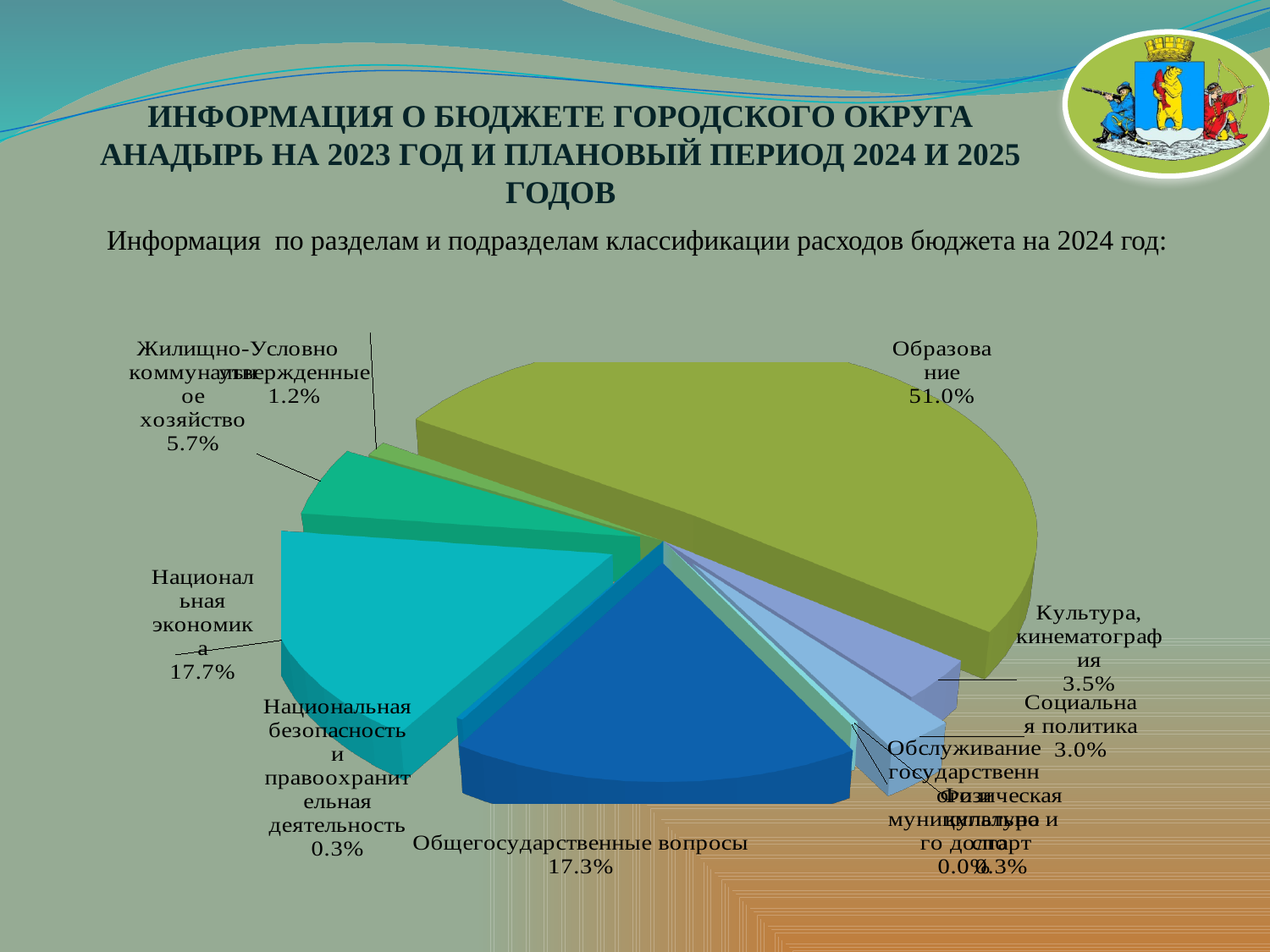
What share is shown for Национальная экономика? 17.7% What share is shown for Общегосударственные вопросы? 17.3% What is the difference between the shares for Образование and Национальная экономика? 33.3% What share of the 2024 budget expenditures goes to Образование? 51.0% What share is shown for Социальная политика? 3.0% What kind of chart is shown on the slide? pie chart Which section has the largest share of the pie? Образование Which is larger: the share for Национальная экономика or for Общегосударственные вопросы? Национальная экономика How many sections (slices) are shown in the pie chart? 10 What share is shown for Жилищно-коммунальное хозяйство? 5.7% What share is shown for Условно утвержденные? 1.2% What share is shown for Культура, кинематография? 3.5%